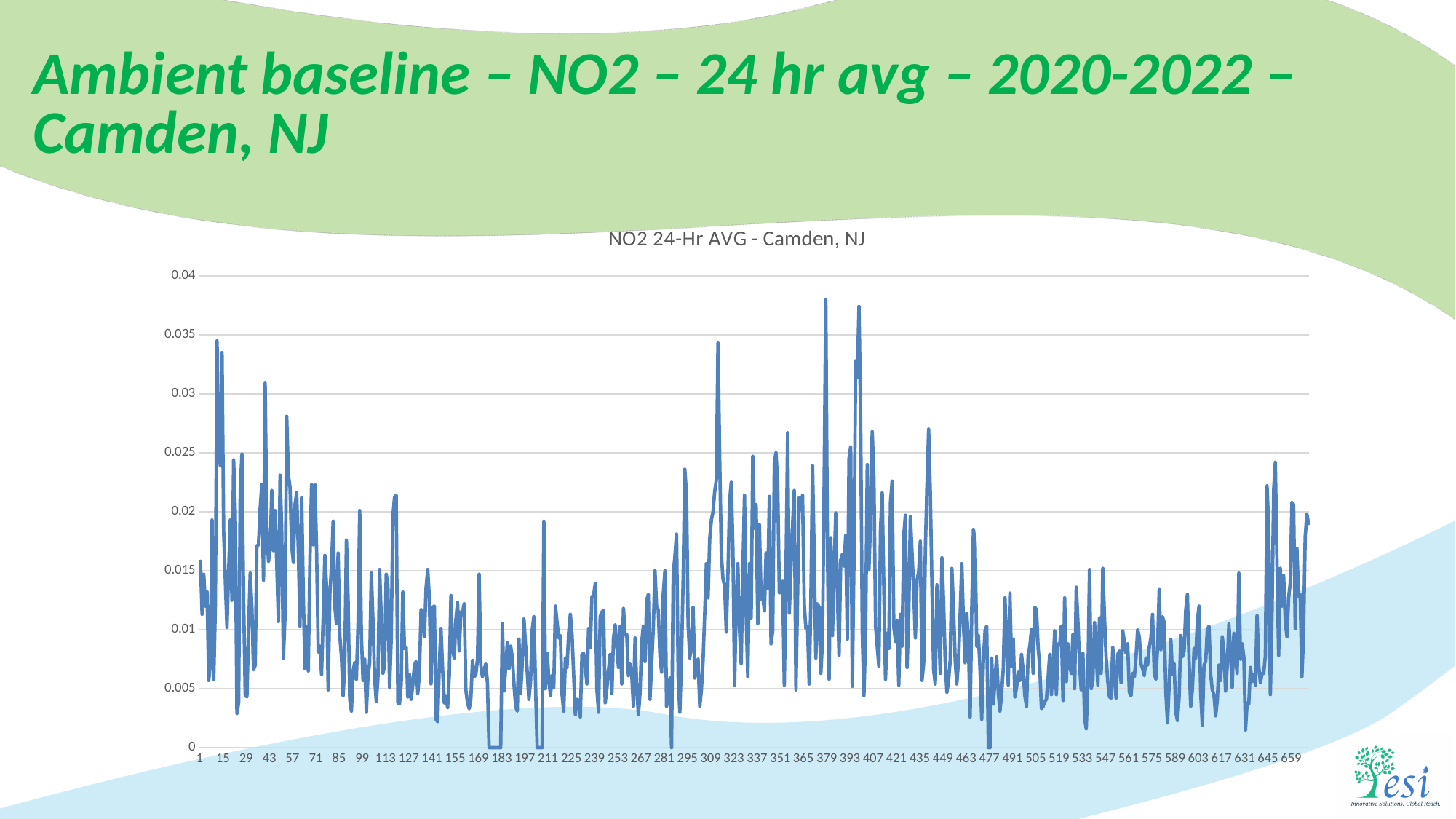
Is the highest peak of the line greater or less than 0.035? greater What is the title of the chart? NO2 24-Hr AVG - Camden, NJ What kind of chart is shown on the slide? line chart What colour is the plotted line? blue How many lines (data series) are plotted on the chart? 1 What is the last label shown on the horizontal axis? 659 Is the highest peak of the line greater or less than 0.04? less What is the first label shown on the horizontal axis? 1 What is the highest value shown on the chart's vertical axis? 0.04